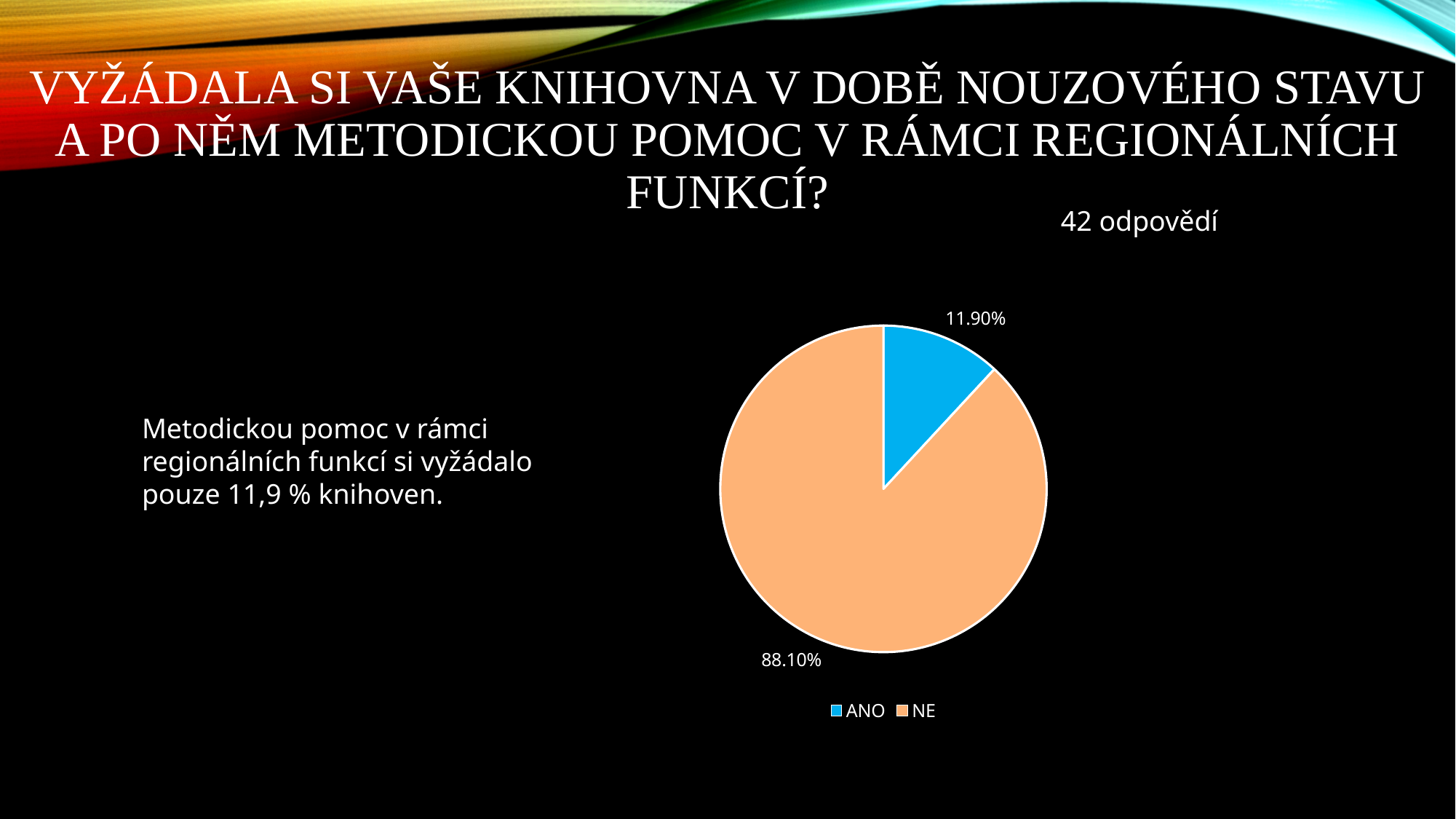
What colour is the NE slice? orange How many entries does the legend list? 2 What is the difference in percentage points between the NE and ANO slices? 76.20% Which category has the largest slice of the pie? NE What is the total of the two slice percentages shown on the pie chart? 100.00% Which category has the smallest slice of the pie? ANO What colour is the ANO slice? blue What kind of chart is shown on the slide? pie chart What share of the pie does the ANO slice represent? 11.90% What share of the pie does the NE slice represent? 88.10% Which slice is larger, ANO or NE? NE How many slices does the pie chart have? 2